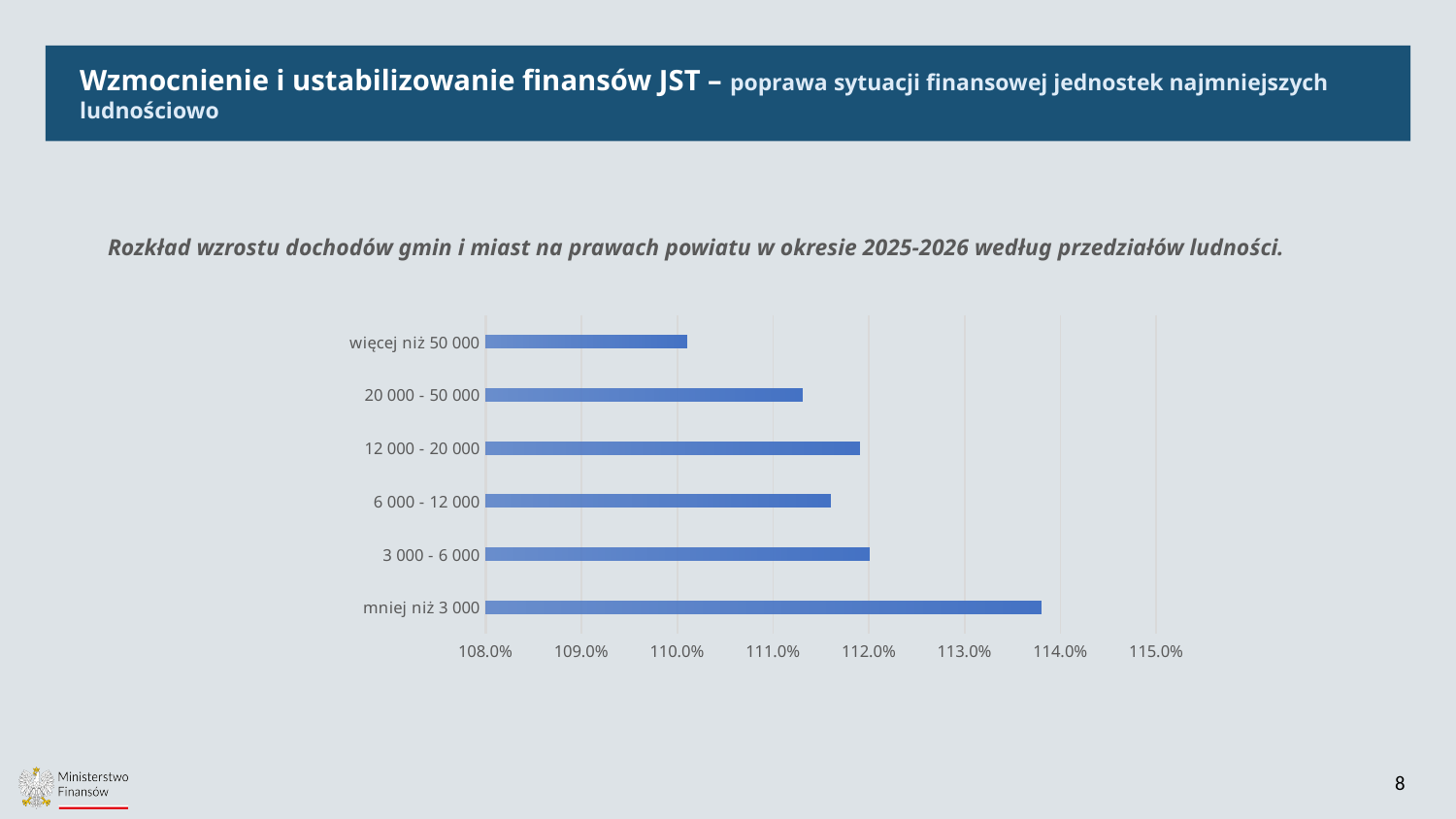
Is the value for 'więcej niż 50 000' greater or less than 111.0%? less Which has a larger value: 'mniej niż 3 000' or '3 000 - 6 000'? mniej niż 3 000 How many population categories are shown in the chart? 6 Is the value for '6 000 - 12 000' greater or less than 112.0%? less Which has a larger value: 'więcej niż 50 000' or '20 000 - 50 000'? 20 000 - 50 000 Is the value for '20 000 - 50 000' greater or less than 111.0%? greater Which population category has the lowest value in the chart? więcej niż 50 000 Which population category has the highest value in the chart? mniej niż 3 000 What is the title of the chart? Rozkład wzrostu dochodów gmin i miast na prawach powiatu w okresie 2025-2026 według przedziałów ludności. What kind of chart is shown on the slide? bar chart